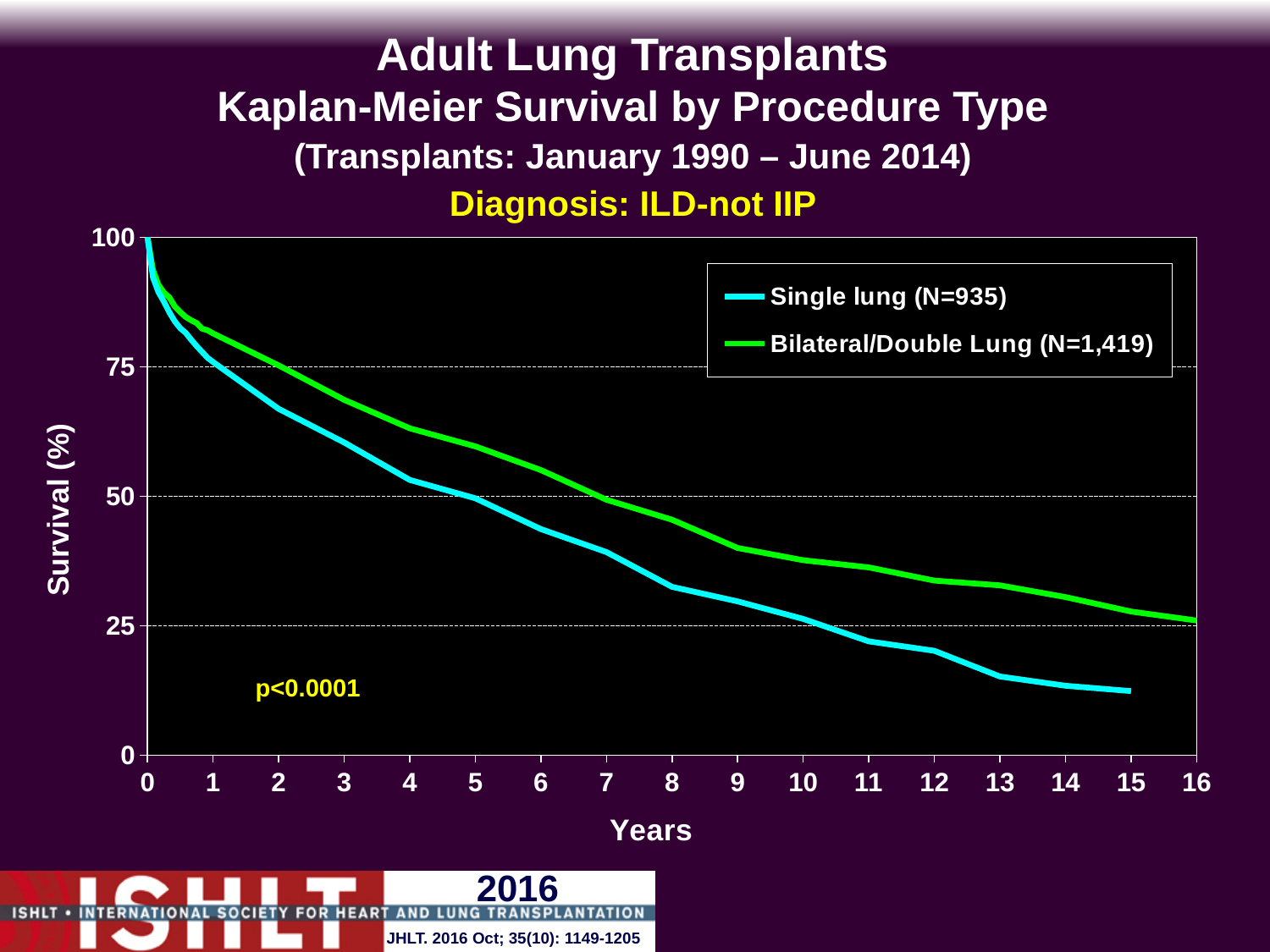
Is the survival value for Single lung at 8 years greater or less than 25? greater What kind of chart is shown on the slide? Line chart Is the survival value for Bilateral/Double Lung at 5 years greater or less than 50? greater Is the survival value for Single lung at 2 years greater or less than 75? less What p-value is printed on the chart? p<0.0001 Which series has the higher survival at 10 years, Single lung or Bilateral/Double Lung? Bilateral/Double Lung How many series does the legend list? 2 What is the N shown in the legend for the Single lung series? N=935 Does survival for the Single lung series rise or fall as years increase? Fall